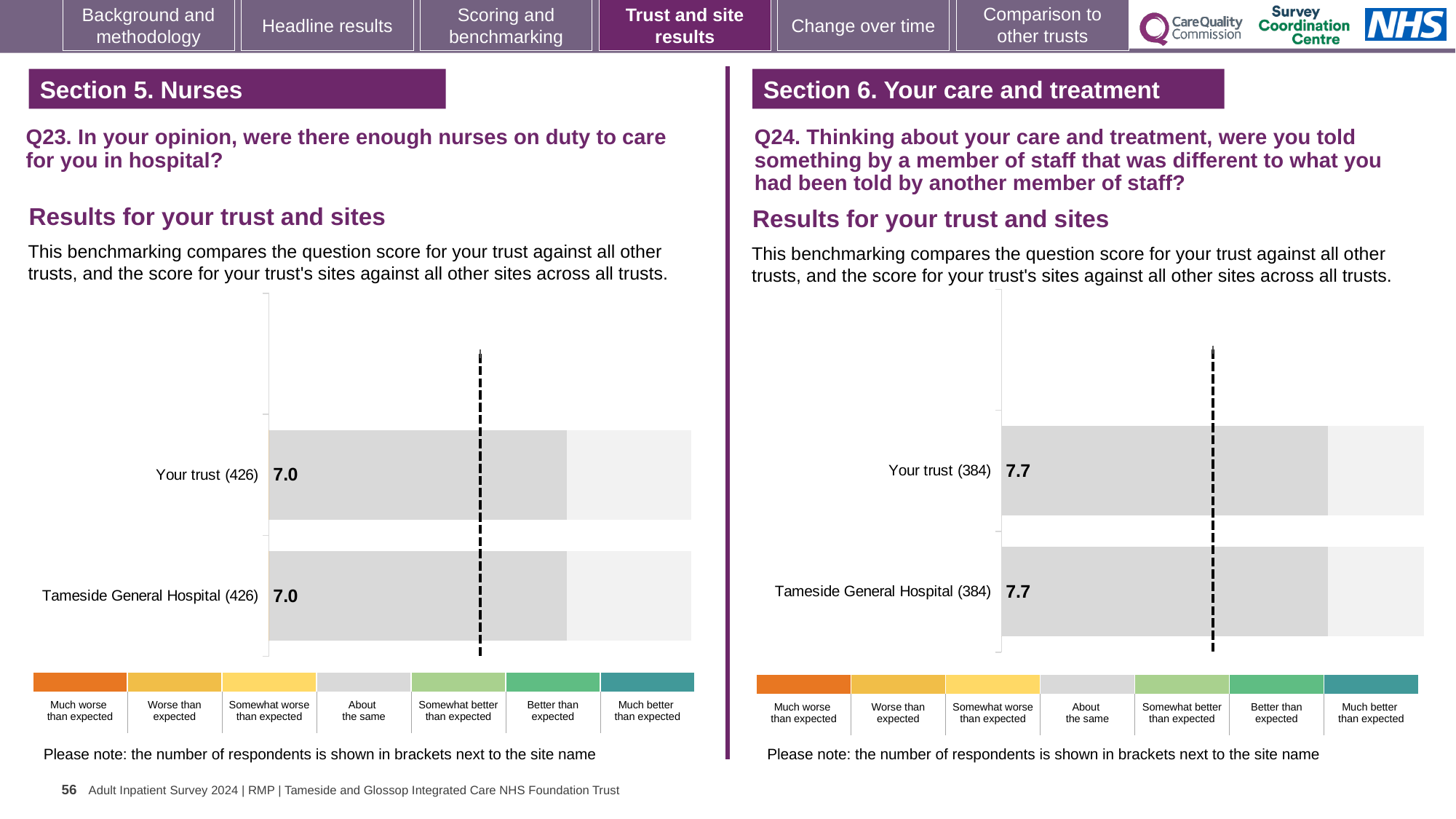
On the Q23 chart (left), how many respondents are shown in brackets next to Your trust? 426 On the Q24 chart (right), what is the score for Your trust? 7.7 On the Q24 chart (right), what is the score for Tameside General Hospital? 7.7 How many bars are plotted on the Q24 chart (right)? 2 Is the score for Your trust on the Q24 chart (right) larger than the score for Your trust on the Q23 chart (left)? Yes On the Q23 chart (left), what is the difference between the score for Your trust and the score for Tameside General Hospital? 0.0 On the Q24 chart (right), how many respondents are shown in brackets next to Tameside General Hospital? 384 On the Q23 chart (left), what is the score for Tameside General Hospital? 7.0 How many bars are plotted on the Q23 chart (left)? 2 On the Q23 chart (left), what is the score for Your trust? 7.0 What kind of chart is the Q23 chart (left)? Bar chart On the Q24 chart (right), what is the difference between the score for Your trust and the score for Tameside General Hospital? 0.0